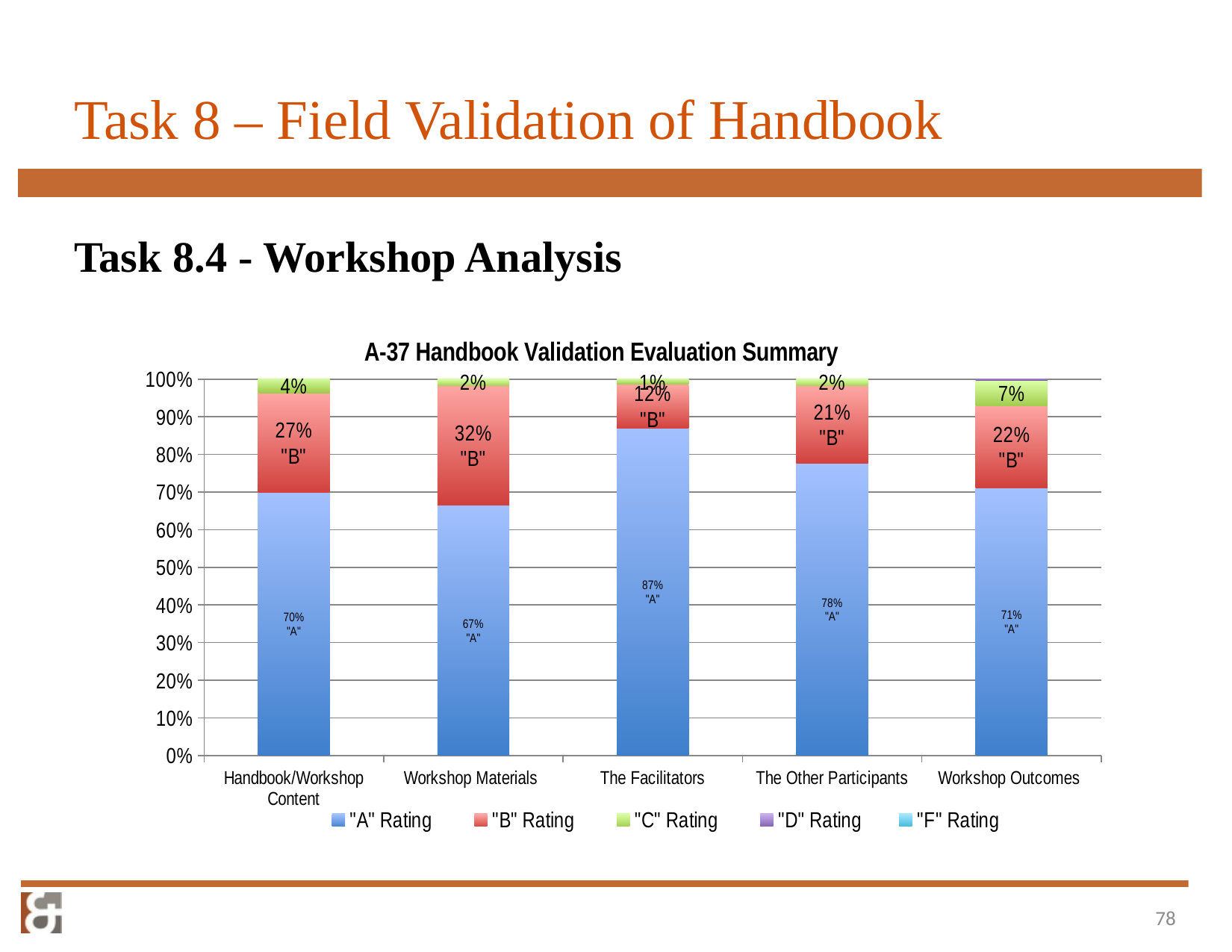
Which category has the highest "A" Rating? The Facilitators What is the "A" Rating value for The Facilitators? 87% What is the "A" Rating value for The Other Participants? 78% What is the title of the chart? A-37 Handbook Validation Evaluation Summary What is the "C" Rating value for Workshop Outcomes? 7% Which category has the lowest "A" Rating? Workshop Materials What is the difference between the "A" Rating for The Facilitators and the "A" Rating for Handbook/Workshop Content? 17% Which is larger, the "B" Rating for Handbook/Workshop Content or the "B" Rating for Workshop Outcomes? Handbook/Workshop Content Which category has the lowest "C" Rating? The Facilitators How many series does the legend list? 5 How many categories are shown on the x axis? 5 What is the "B" Rating value for Workshop Materials? 32%